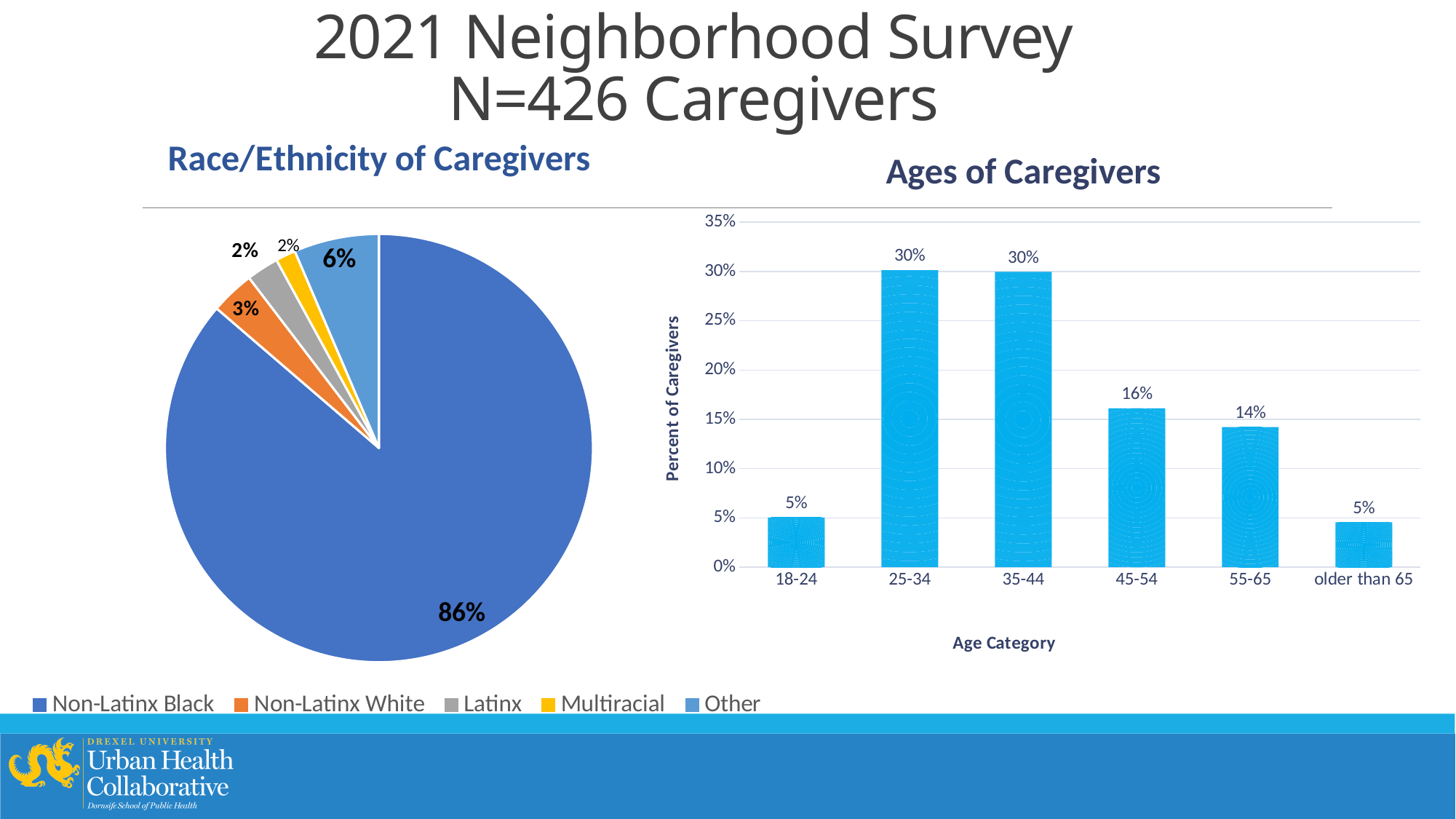
What kind of chart is the Race/Ethnicity of Caregivers chart? Pie chart In the Race/Ethnicity of Caregivers chart, which category has the largest slice? Non-Latinx Black In the Ages of Caregivers chart, how many age categories are shown on the x axis? 6 In the Race/Ethnicity of Caregivers chart, what share of caregivers are Non-Latinx Black? 86% In the Ages of Caregivers chart, what is the difference between the values for 25-34 and 45-54? 14% In the Ages of Caregivers chart, what percent of caregivers are aged 25-34? 30% In the Race/Ethnicity of Caregivers chart, what share of caregivers are Non-Latinx White? 3% In the Race/Ethnicity of Caregivers chart, how many categories does the legend list? 5 In the Ages of Caregivers chart, what percent of caregivers are older than 65? 5% In the Ages of Caregivers chart, what percent of caregivers are aged 55-65? 14% In the Race/Ethnicity of Caregivers chart, what share of caregivers fall in the Other category? 6% In the Ages of Caregivers chart, which is larger, the value for 45-54 or the value for 55-65? 45-54